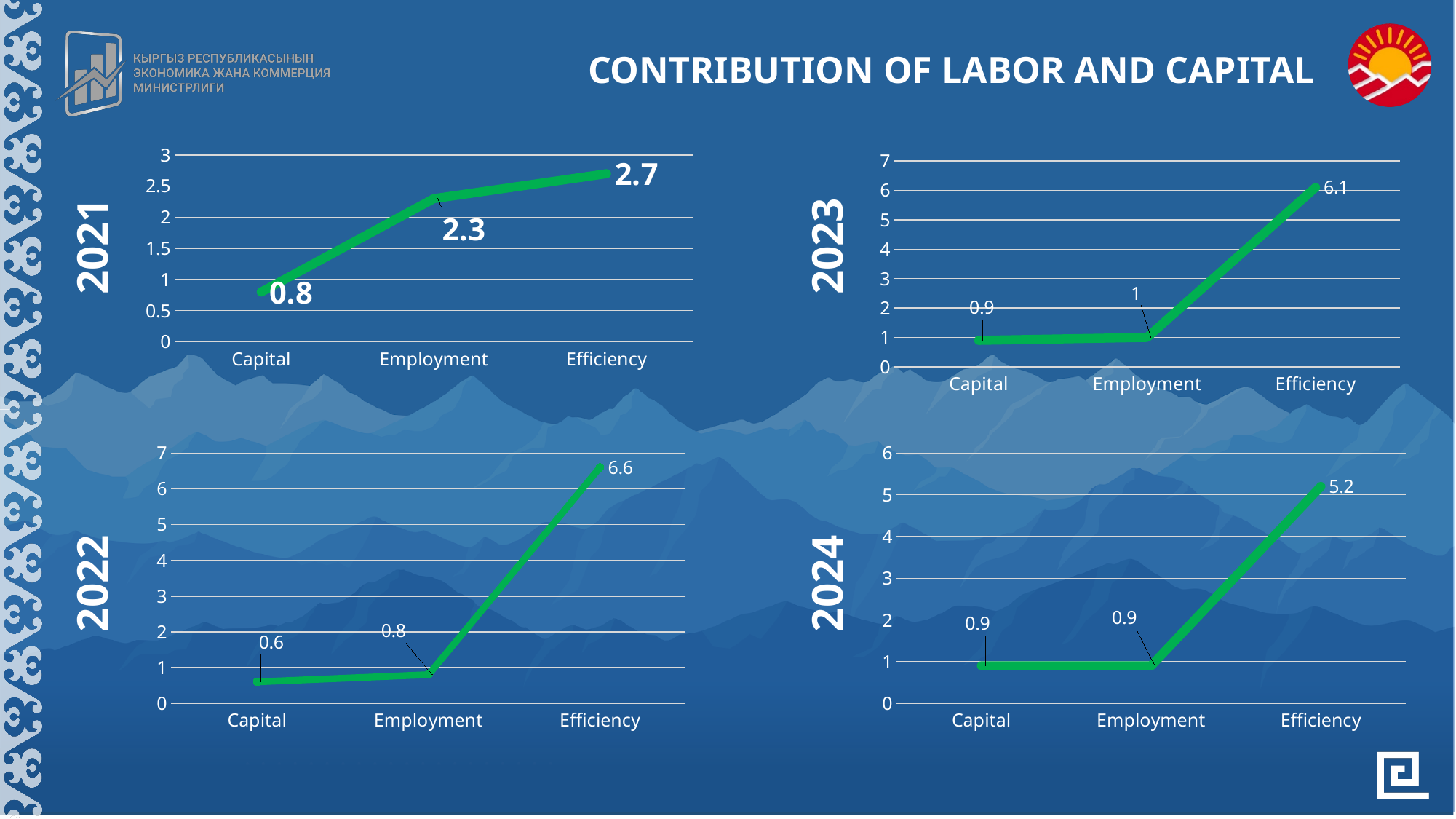
In the 2021 chart, what is the value for Capital? 0.8 In the 2022 chart, what is the difference between the Efficiency and Employment values? 5.8 In the 2024 chart, what is the value for Efficiency? 5.2 In the 2024 chart, is the value for Efficiency greater or less than the value for Capital? greater In the 2022 chart, what is the value for Efficiency? 6.6 In the 2023 chart, what is the value for Employment? 1 What kind of chart is the 2023 chart? Line chart In the 2021 chart, what is the value for Employment? 2.3 In the 2021 chart, what is the difference between the Efficiency and Capital values? 1.9 In the 2023 chart, which category has the highest value? Efficiency In the 2022 chart, which category has the lowest value? Capital How many categories are shown on the x axis of the 2024 chart? 3